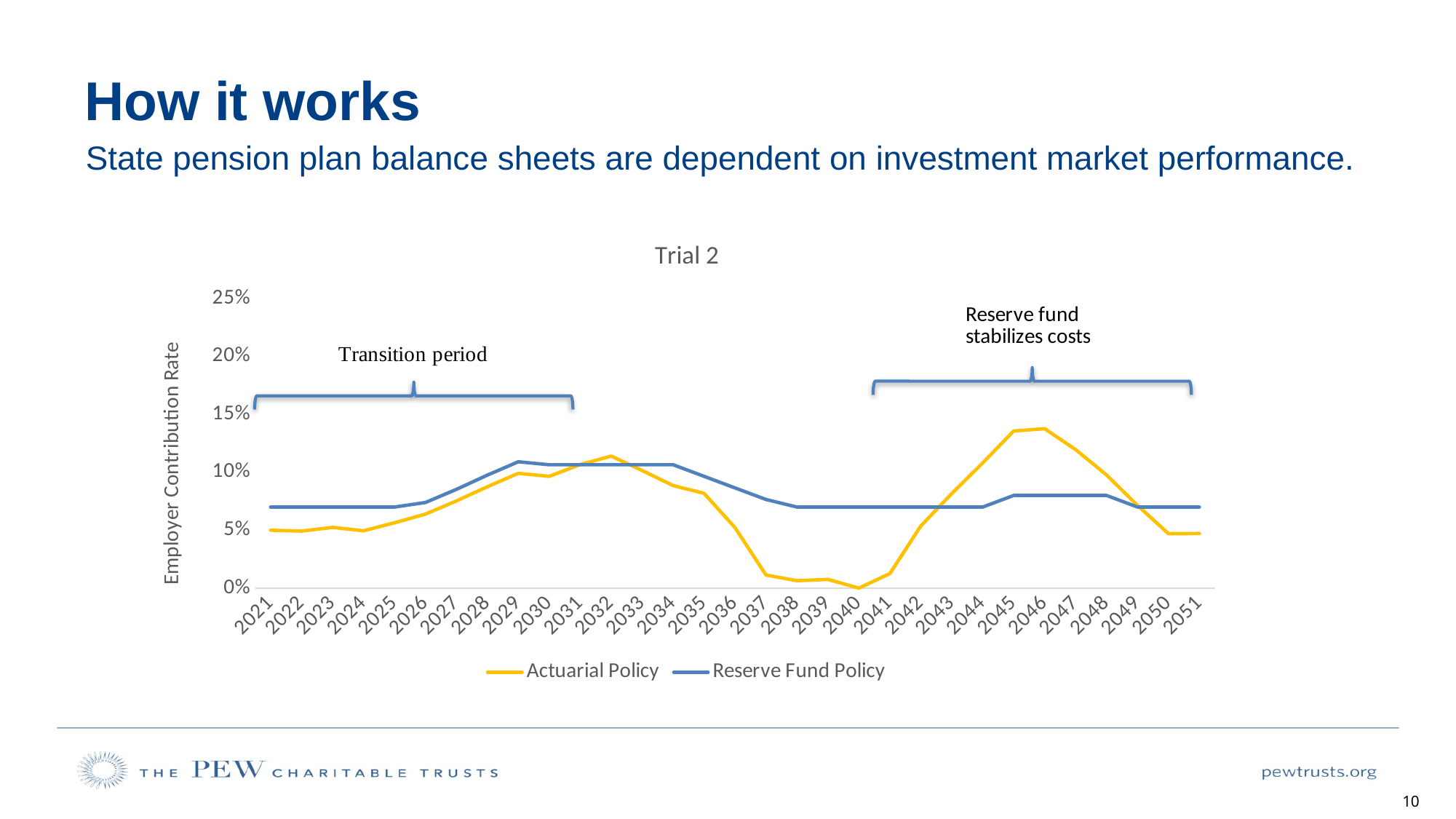
Is the Actuarial Policy value for 2046 greater or less than 10%? greater What kind of chart is shown on the slide? line chart How many years are shown along the x axis? 31 In 2037, which series has the higher value, Actuarial Policy or Reserve Fund Policy? Reserve Fund Policy In 2046, which series has the higher value, Actuarial Policy or Reserve Fund Policy? Actuarial Policy What is the title of the chart? Trial 2 What is the label on the vertical axis? Employer Contribution Rate In which year does the Actuarial Policy line reach its lowest value? 2040 How many series does the legend list? 2 Does the Actuarial Policy line rise or fall from 2046 to 2050? fall Is the Reserve Fund Policy value for 2021 greater or less than 5%? greater Is the Actuarial Policy value for 2040 greater or less than 5%? less